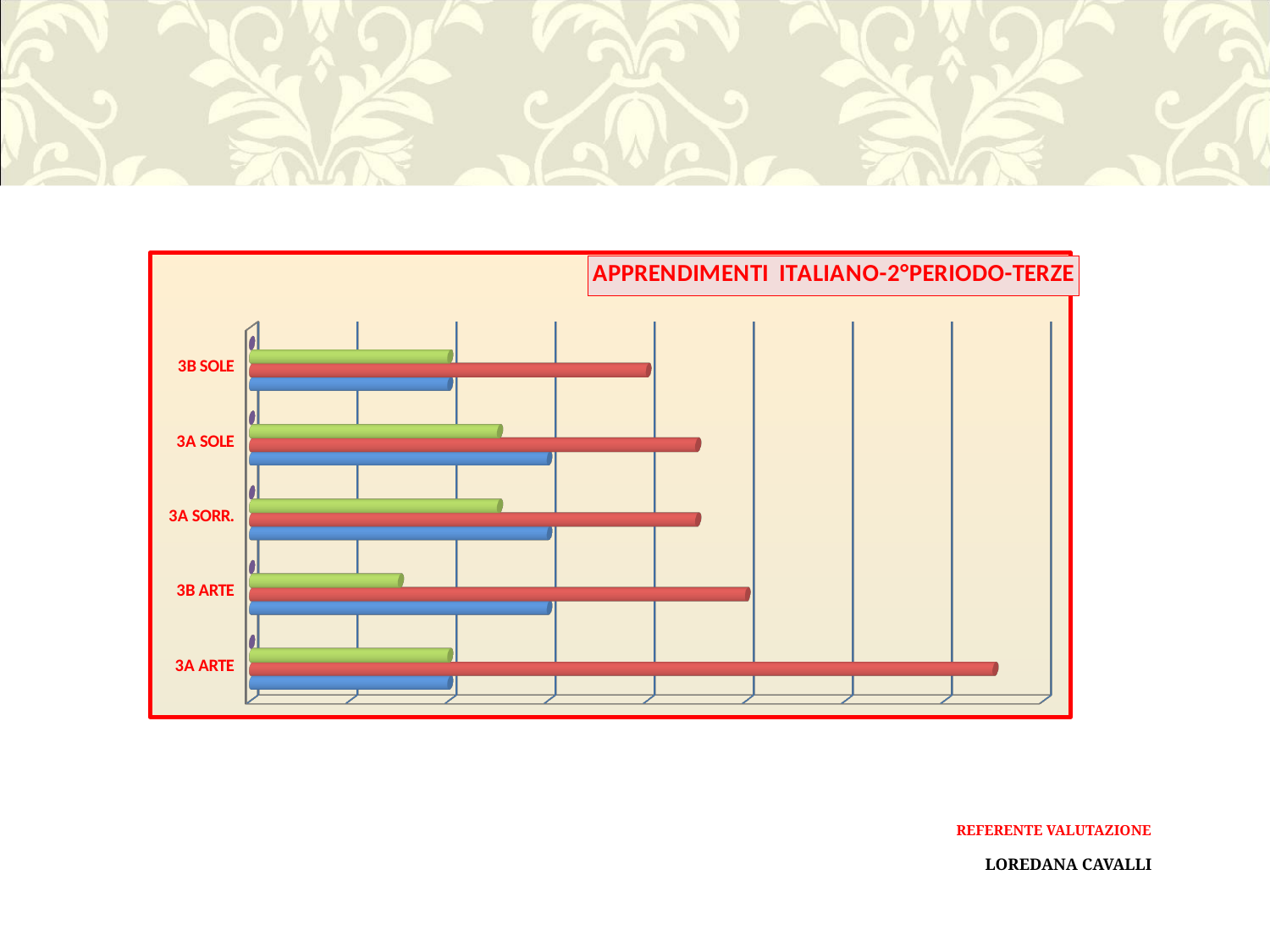
Which category has the shortest green bar? 3B ARTE What kind of chart is shown on the slide? bar chart Which category is listed at the top of the chart? 3B SOLE Which category has the shortest red bar? 3B SOLE How many bars are drawn for each category? 3 Which category has the longest red bar? 3A ARTE What is the title of the chart? APPRENDIMENTI ITALIANO-2°PERIODO-TERZE For 3B ARTE, which bar is longer, the blue one or the green one? blue Which category has the longer green bar, 3A SOLE or 3B ARTE? 3A SOLE Which category has the longer red bar, 3A ARTE or 3B SOLE? 3A ARTE How many categories (classes) are shown on the chart? 5